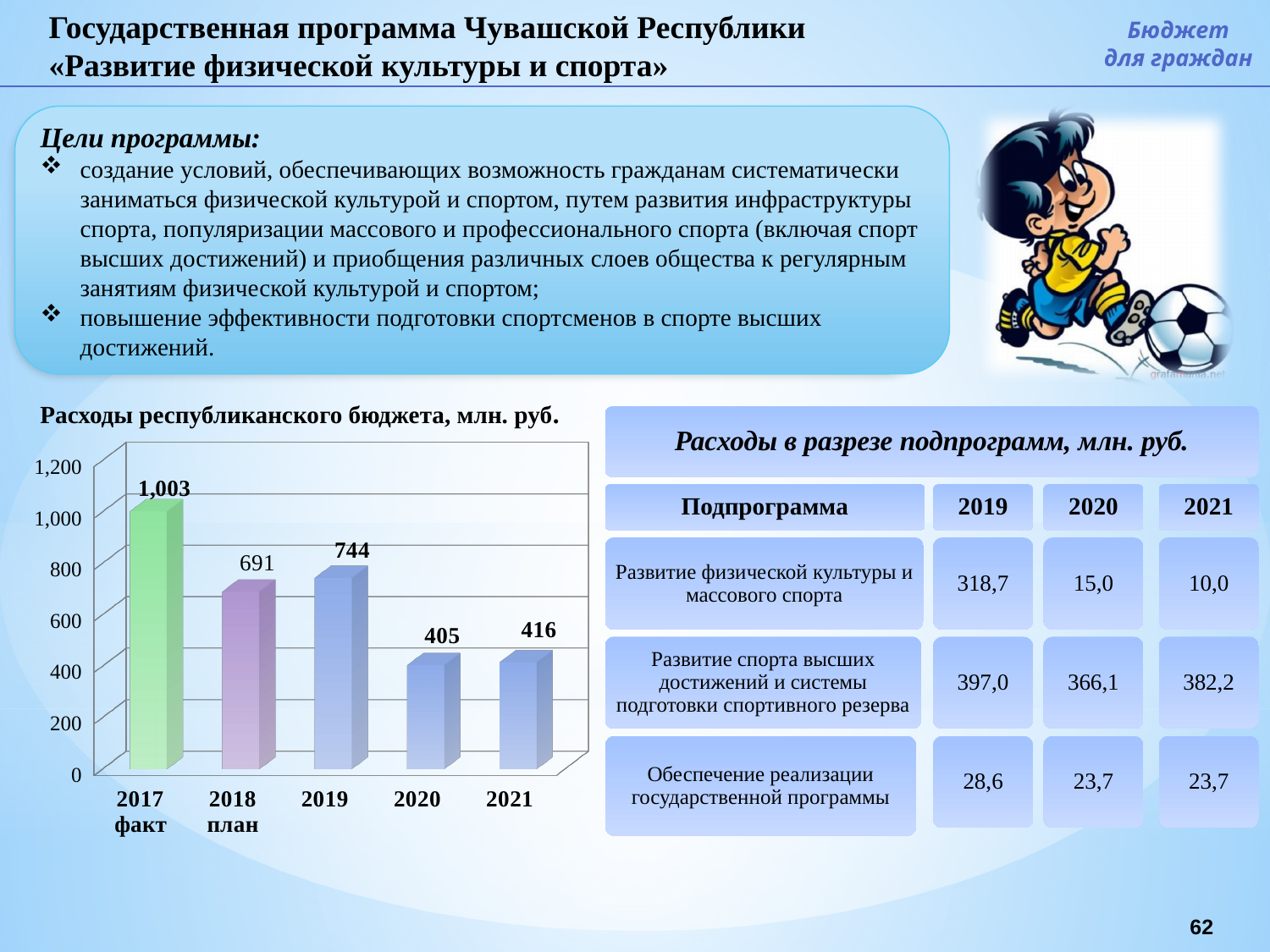
Which is larger in the chart 'Расходы республиканского бюджета, млн. руб.': the value for 2018 план or the value for 2019? 2019 Which year has the highest value in the chart 'Расходы республиканского бюджета, млн. руб.'? 2017 факт How many years are shown on the x axis of the chart 'Расходы республиканского бюджета, млн. руб.'? 5 What kind of chart is 'Расходы республиканского бюджета, млн. руб.'? bar chart What is the difference between the values for 2017 факт and 2018 план in the chart 'Расходы республиканского бюджета, млн. руб.'? 312 What is the value for 2017 факт in the chart 'Расходы республиканского бюджета, млн. руб.'? 1,003 Which year has the lowest value in the chart 'Расходы республиканского бюджета, млн. руб.'? 2020 What is the title of the chart on the left side of the slide? Расходы республиканского бюджета, млн. руб. What is the value for 2019 in the chart 'Расходы республиканского бюджета, млн. руб.'? 744 Is the value for 2021 in the chart 'Расходы республиканского бюджета, млн. руб.' greater or less than 600? less What is the value for 2020 in the chart 'Расходы республиканского бюджета, млн. руб.'? 405 What is the difference between the values for 2019 and 2020 in the chart 'Расходы республиканского бюджета, млн. руб.'? 339